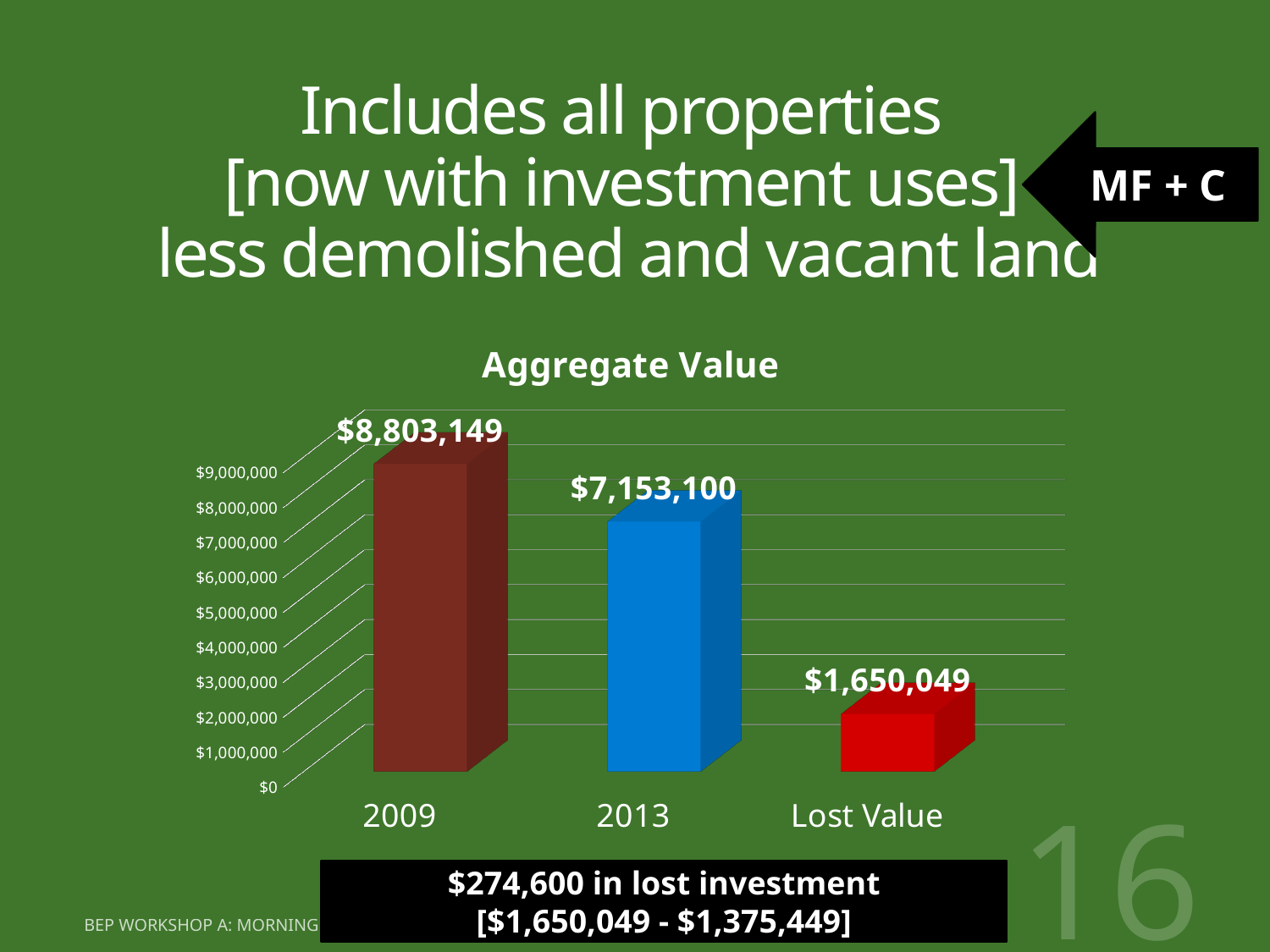
What is the value for 2013 in the Aggregate Value chart? $7,153,100 What colour is the bar for 2013 in the Aggregate Value chart? blue What is the value for Lost Value in the Aggregate Value chart? $1,650,049 Which category has the highest value in the Aggregate Value chart? 2009 Is the value for 2013 in the Aggregate Value chart greater or less than $8,000,000? less How many categories are shown on the x axis of the Aggregate Value chart? 3 What is the title of the chart on the slide? Aggregate Value What is the value for 2009 in the Aggregate Value chart? $8,803,149 Which category has the lowest value in the Aggregate Value chart? Lost Value Which is larger in the Aggregate Value chart, the value for 2013 or the value for Lost Value? 2013 What kind of chart is the Aggregate Value chart? bar chart What is the difference between the 2009 and 2013 values in the Aggregate Value chart? $1,650,049